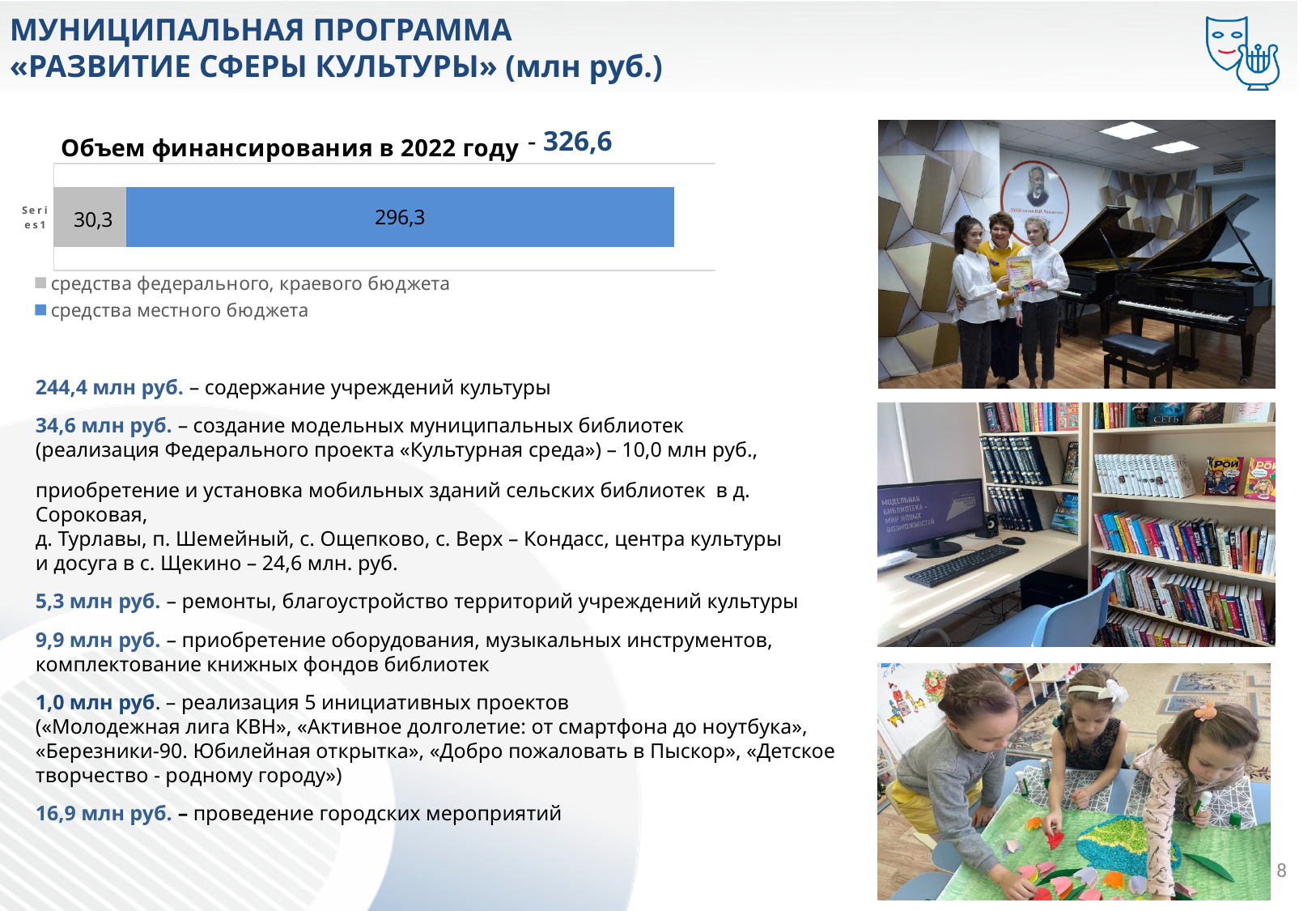
Which series has the larger value: «средства местного бюджета» or «средства федерального, краевого бюджета»? средства местного бюджета What is the value for «средства федерального, краевого бюджета» in the chart? 30,3 Which colour represents «средства местного бюджета» in the chart? blue What is the title of the chart? Объем финансирования в 2022 году How many bars are plotted in the chart? 1 What is the total of the stacked bar in the chart? 326,6 Which series has the smallest value in the chart? средства федерального, краевого бюджета What type of chart is shown on the slide? bar chart How many series does the chart legend list? 2 Which series has the largest value in the chart? средства местного бюджета What is the value for «средства местного бюджета» in the chart? 296,3 What is the difference between the value for «средства местного бюджета» and the value for «средства федерального, краевого бюджета»? 266,0